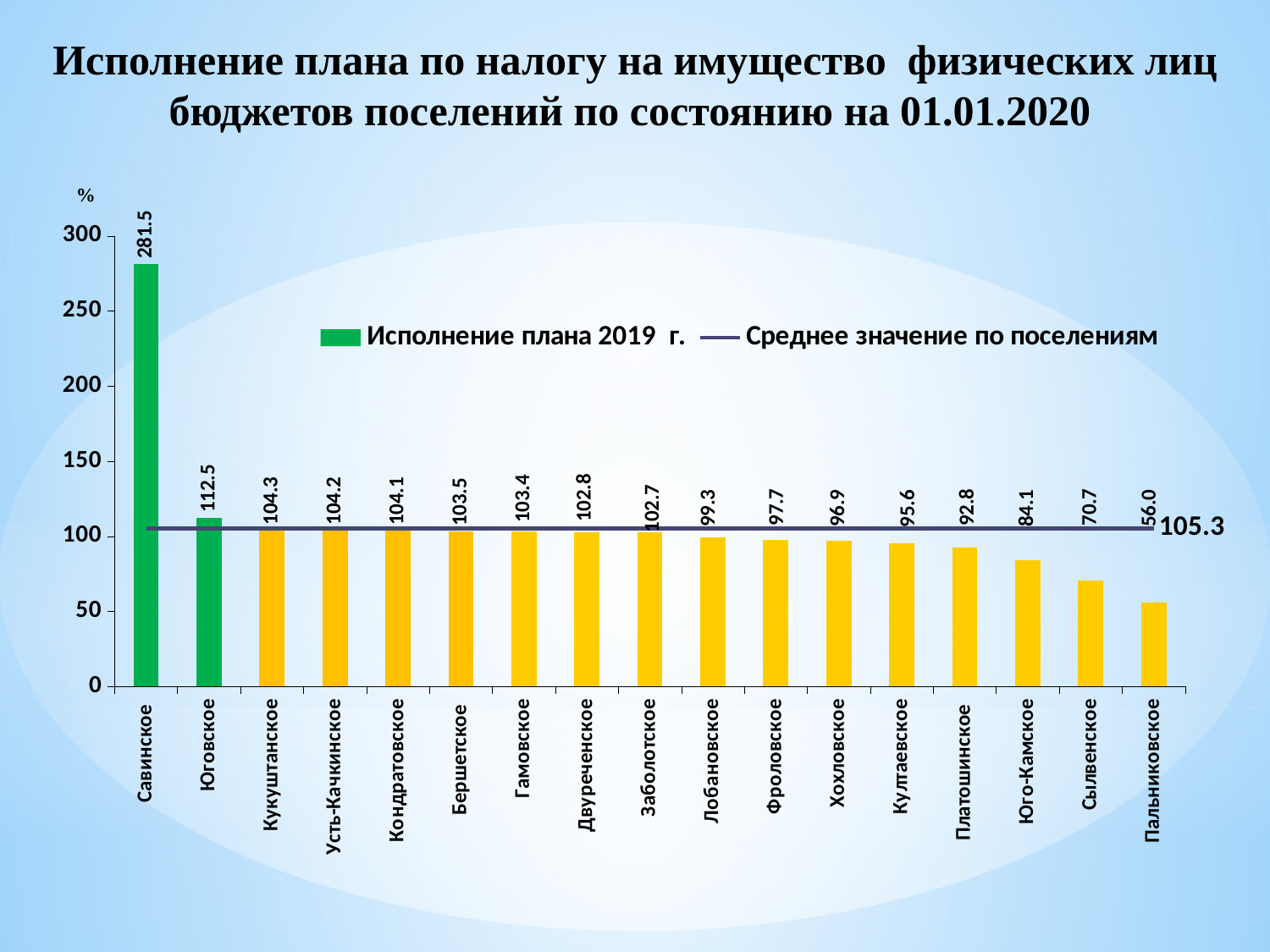
What is the difference between the values for Савинское and Юговское? 169.0 What is the average value shown by the line (Среднее значение по поселениям)? 105.3 What is the value for Лобановское? 99.3 What kind of chart is shown on the slide? Combination bar and line chart (bars with an average line) Which category has the highest value? Савинское What is the value for Пальниковское? 56.0 Which category has the lowest value? Пальниковское Which is larger, the value for Сылвенское or the value for Юго-Камское? Юго-Камское How many entries does the legend list? 2 Do the bar values rise or fall from left to right along the x axis? Fall What is the value for Савинское? 281.5 How many categories are shown on the x axis? 17